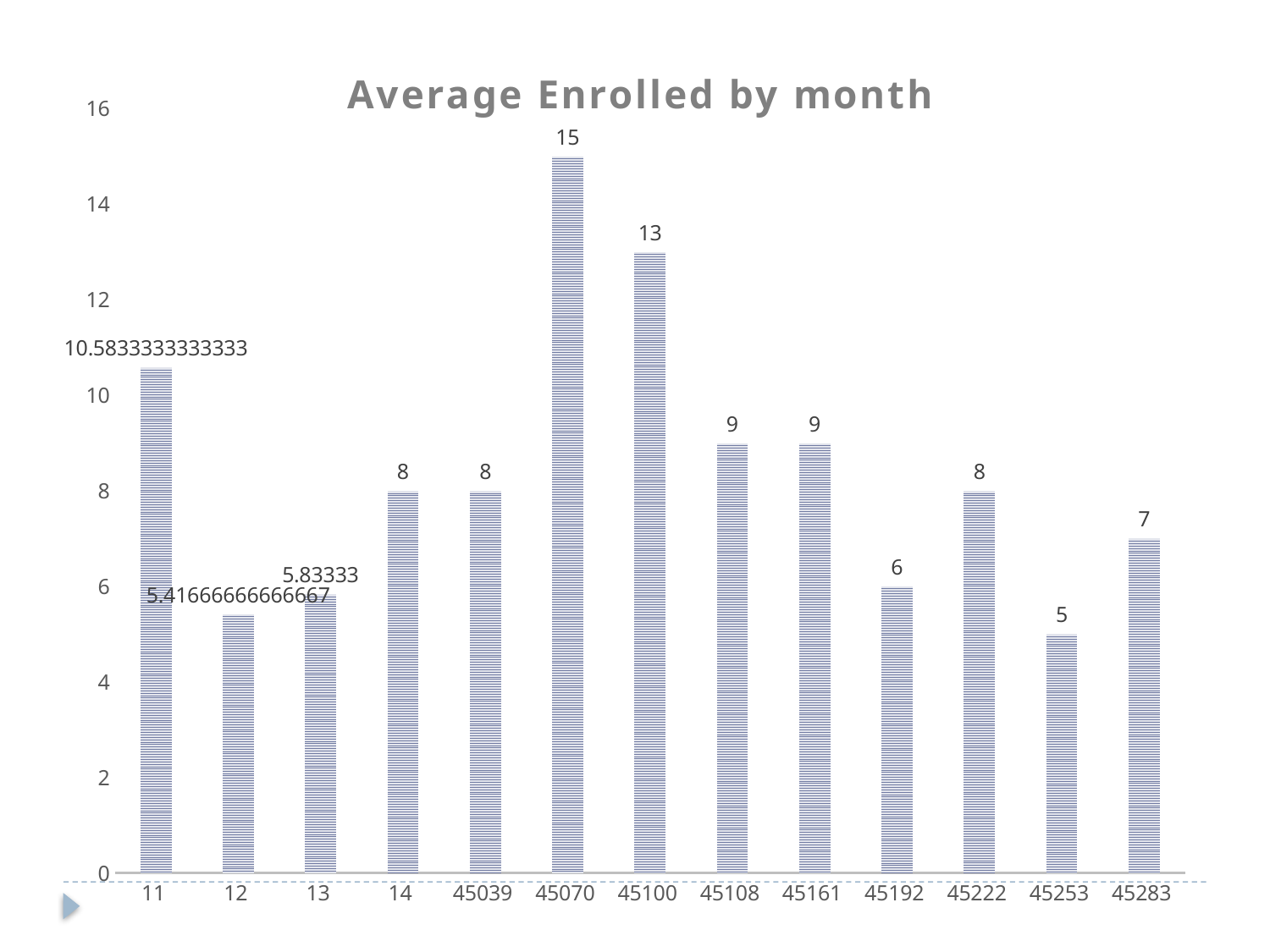
What is the title of the chart? Average Enrolled by month What is the value for category 45070? 15 What is the value for category 45100? 13 What is the difference between the values for 45070 and 45100? 2 Is the value for category 11 greater or less than 10? greater Which is larger, the value for 45192 or the value for 45283? 45283 Which category has the highest value? 45070 Which category has the lowest value? 45253 How many categories are plotted on the x axis? 13 What kind of chart is shown on the slide? bar chart What is the value for category 13? 5.83333 What is the value for category 45253? 5